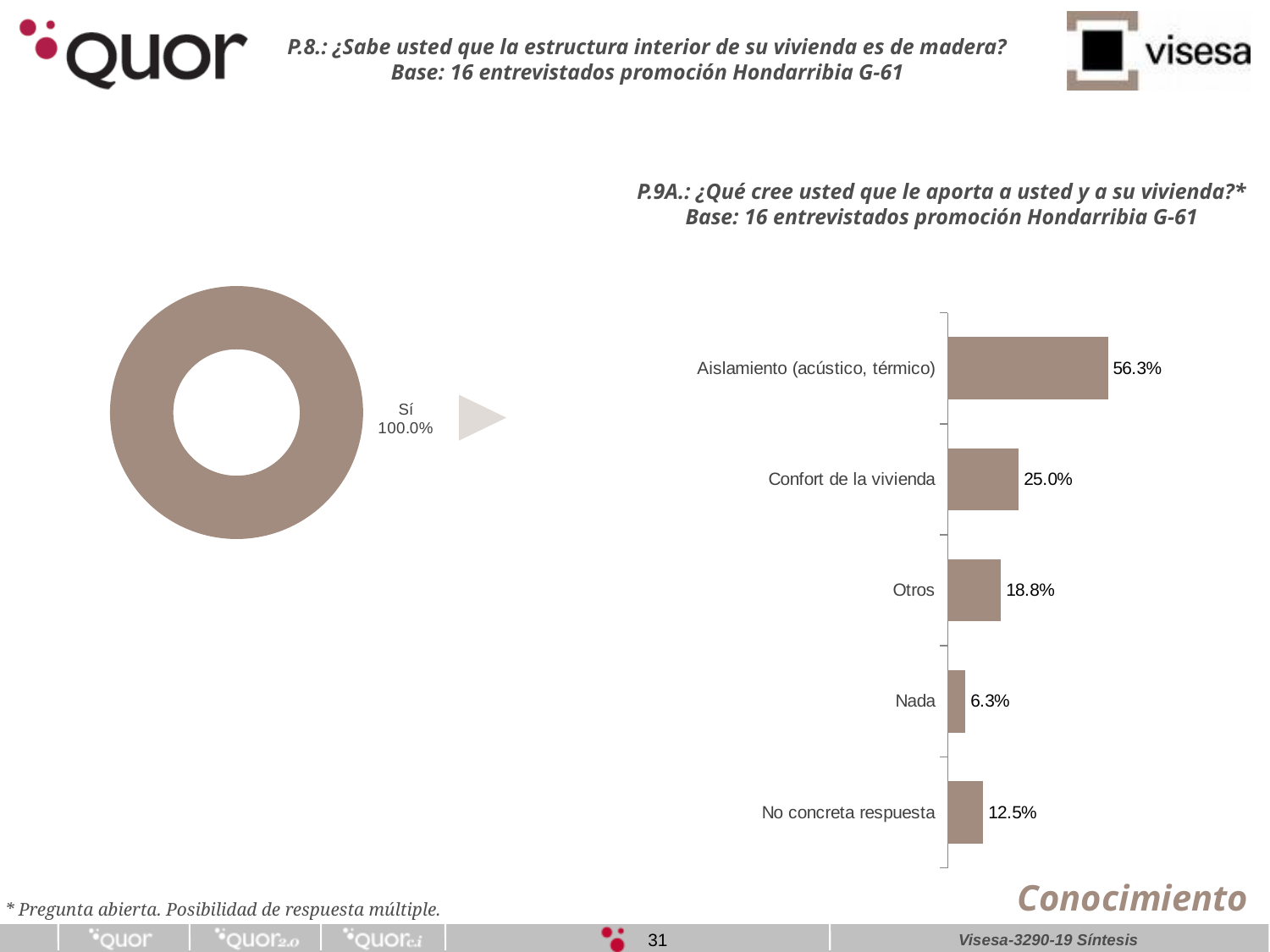
How many categories are shown in the P.9A bar chart on the right? 5 What kind of chart is the P.8 chart on the left of the slide? Donut (pie) chart In the P.9A bar chart on the right, what is the value for Nada? 6.3% In the P.9A bar chart on the right, what is the value for No concreta respuesta? 12.5% In the P.9A bar chart on the right, what is the value for Confort de la vivienda? 25.0% In the P.9A bar chart on the right, which category has the highest value? Aislamiento (acústico, térmico) In the P.9A bar chart on the right, what is the difference between Aislamiento (acústico, térmico) and Confort de la vivienda? 31.3% In the P.9A bar chart on the right, which is larger: Otros or No concreta respuesta? Otros In the P.8 donut chart on the left, what share does the Sí slice represent? 100.0% What kind of chart is the P.9A chart on the right of the slide? Bar chart In the P.9A bar chart on the right, what is the value for Aislamiento (acústico, térmico)? 56.3% In the P.9A bar chart on the right, which category has the lowest value? Nada